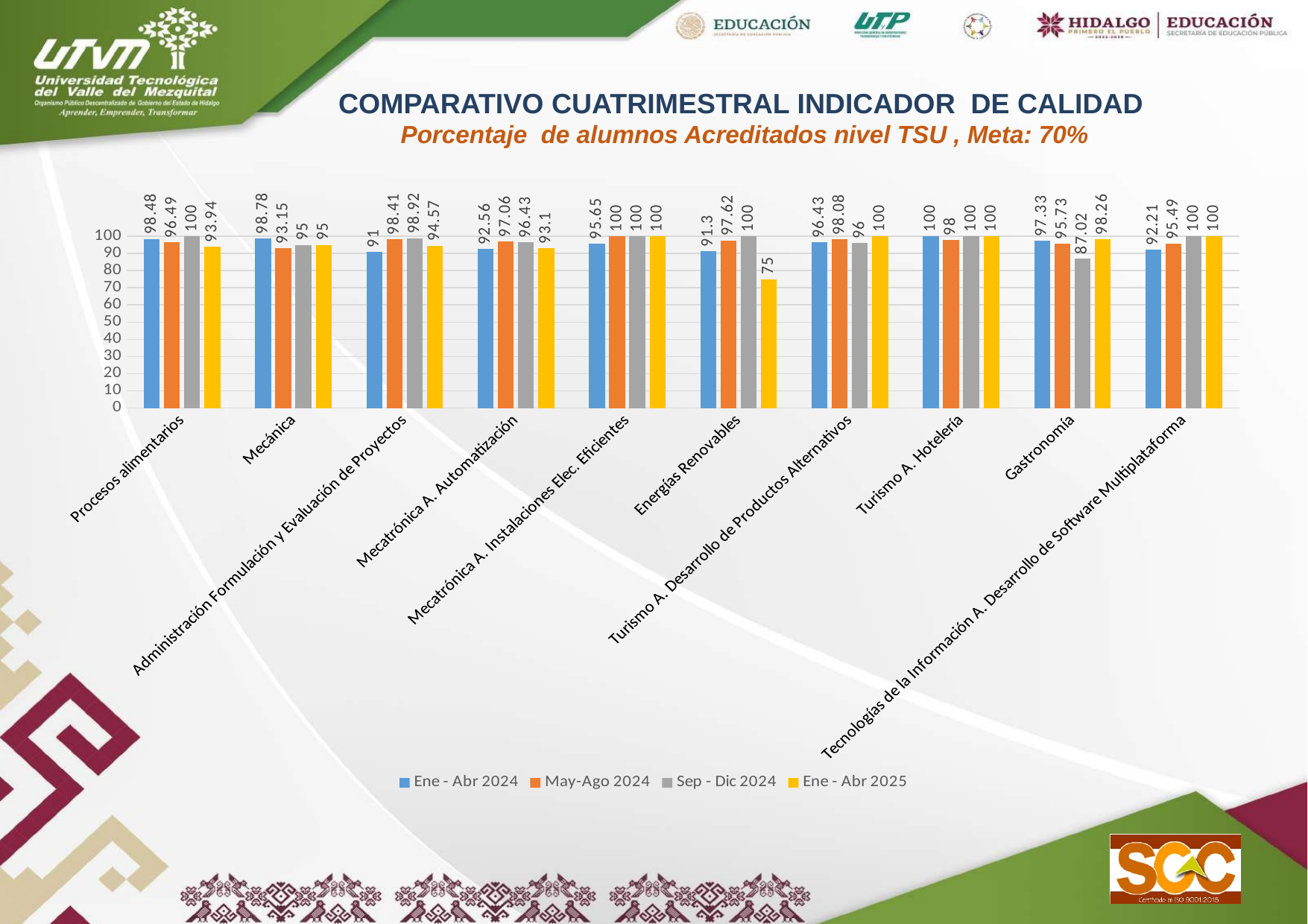
Which category has the lowest value in the Ene - Abr 2025 series? Energías Renovables What kind of chart is shown on the slide? Bar chart What is the difference between the Sep - Dic 2024 and Ene - Abr 2025 values for Energías Renovables? 25 Which category has the lowest value in the Sep - Dic 2024 series? Gastronomía What target (Meta) is stated in the chart subtitle? 70% What is the value for Gastronomía in the Sep - Dic 2024 series? 87.02 What is the value for Administración Formulación y Evaluación de Proyectos in the May-Ago 2024 series? 98.41 How many categories (programs) are shown on the x axis? 10 What is the value for Energías Renovables in the Ene - Abr 2025 series? 75 How many series does the legend list? 4 What is the value for Mecánica in the Ene - Abr 2024 series? 98.78 Which is larger for Procesos alimentarios: the Ene - Abr 2024 value or the Ene - Abr 2025 value? Ene - Abr 2024